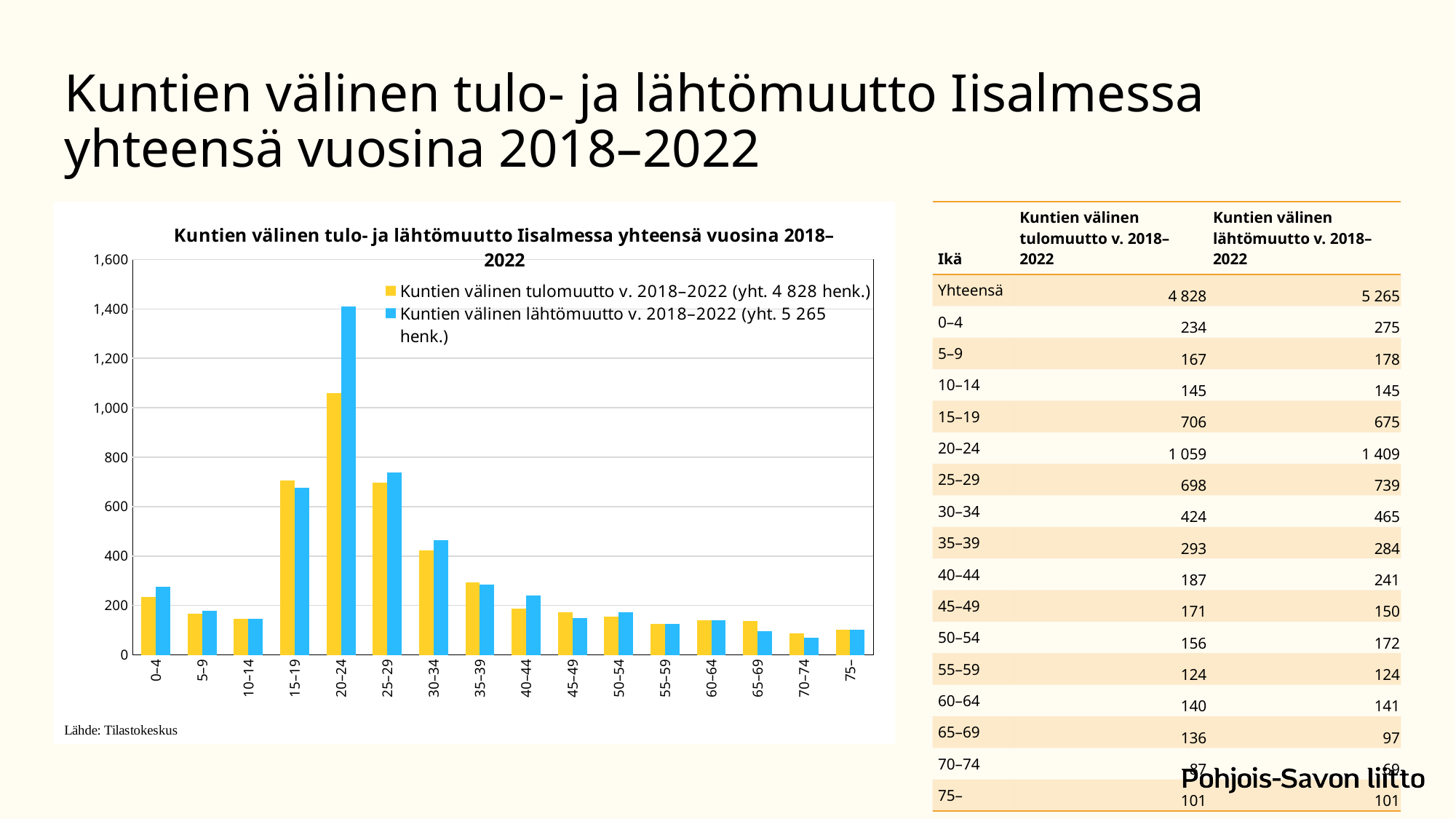
What kind of chart is shown on the slide? bar chart How many series does the chart's legend list? 2 For the 20–24 age group, what is the difference between lähtömuutto and tulomuutto? 350 How many age groups are shown on the x axis of the chart? 16 What is the value of Kuntien välinen lähtömuutto v. 2018–2022 for the 20–24 age group? 1 409 What is the value of Kuntien välinen tulomuutto v. 2018–2022 for the 20–24 age group? 1 059 Which age group has the highest value for Kuntien välinen lähtömuutto v. 2018–2022? 20–24 Do the tulomuutto values rise or fall along the x axis from the 20–24 group to the 35–39 group? fall For the 15–19 age group, which is larger: tulomuutto or lähtömuutto? tulomuutto According to the chart legend, what is the total number of persons for Kuntien välinen tulomuutto v. 2018–2022? 4 828 henk. Which age group has the lowest value for Kuntien välinen lähtömuutto v. 2018–2022? 70–74 Is the value of Kuntien välinen tulomuutto for the 20–24 age group greater or less than 1,000? greater